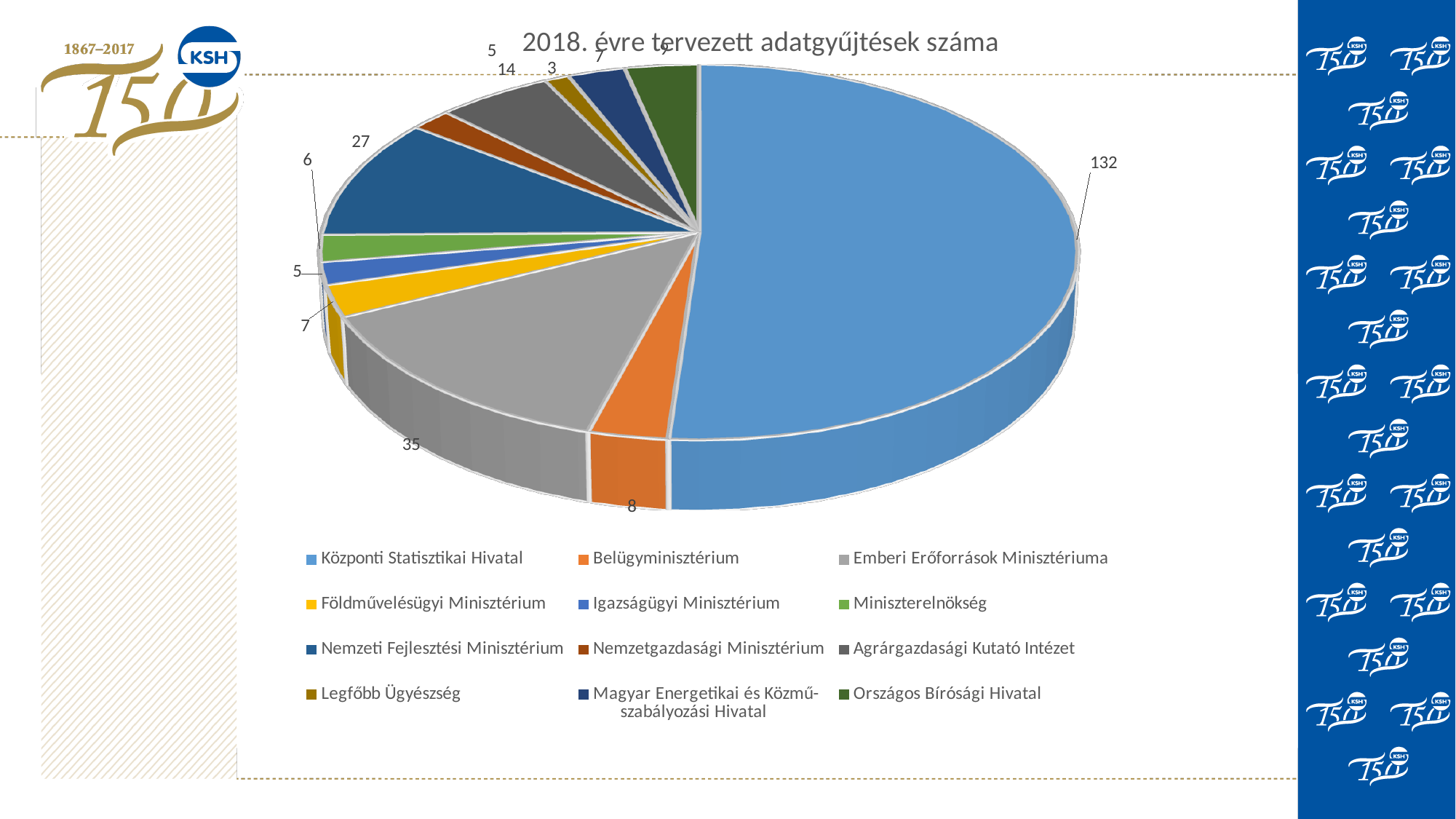
What is the value for Nemzeti Fejlesztési Minisztérium? 27 What is the title of the chart? 2018. évre tervezett adatgyűjtések száma What is the difference between the values for Nemzeti Fejlesztési Minisztérium and Belügyminisztérium? 19 What is the value for Emberi Erőforrások Minisztériuma? 35 What is the value for Miniszterelnökség? 6 What is the difference between the values for Központi Statisztikai Hivatal and Emberi Erőforrások Minisztériuma? 97 How many categories does the legend list? 12 Which is larger, the value for Földművelésügyi Minisztérium or the value for Igazságügyi Minisztérium? Földművelésügyi Minisztérium What kind of chart is shown on the slide? pie chart What is the value for Belügyminisztérium? 8 Which category has the largest slice of the pie? Központi Statisztikai Hivatal What is the value for Központi Statisztikai Hivatal? 132